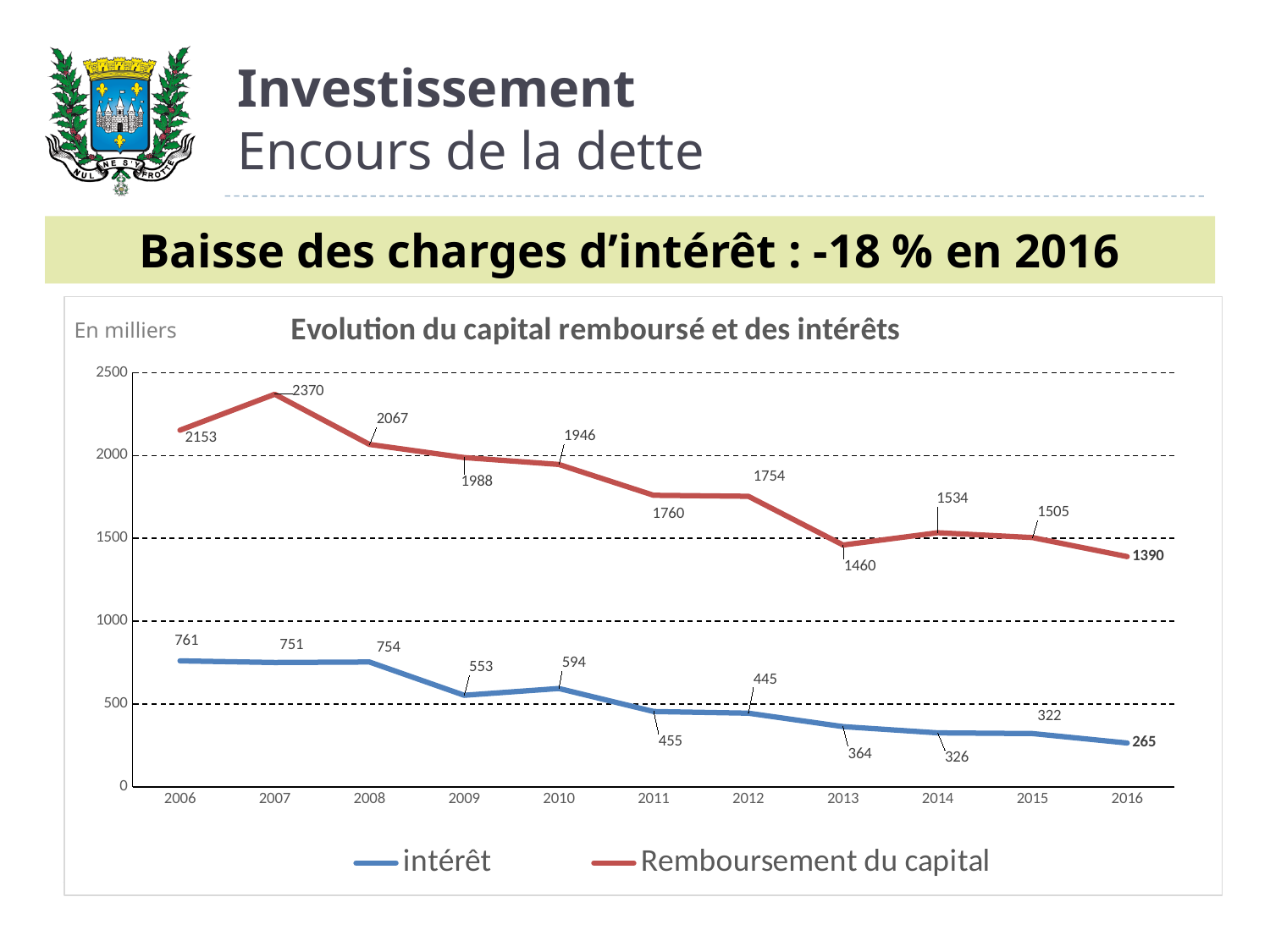
What is the title of the chart? Evolution du capital remboursé et des intérêts In which year is intérêt lowest? 2016 Is the value of Remboursement du capital in 2013 greater or less than 1500? less What is the value of intérêt in 2016? 265 In which year is Remboursement du capital highest? 2007 How many series does the legend list? 2 What is the difference between Remboursement du capital in 2006 and in 2016? 763 Which is larger: intérêt in 2009 or intérêt in 2010? 2010 What kind of chart is shown? line chart What is the value of Remboursement du capital in 2007? 2370 What is the value of intérêt in 2010? 594 How many years are shown on the x axis? 11